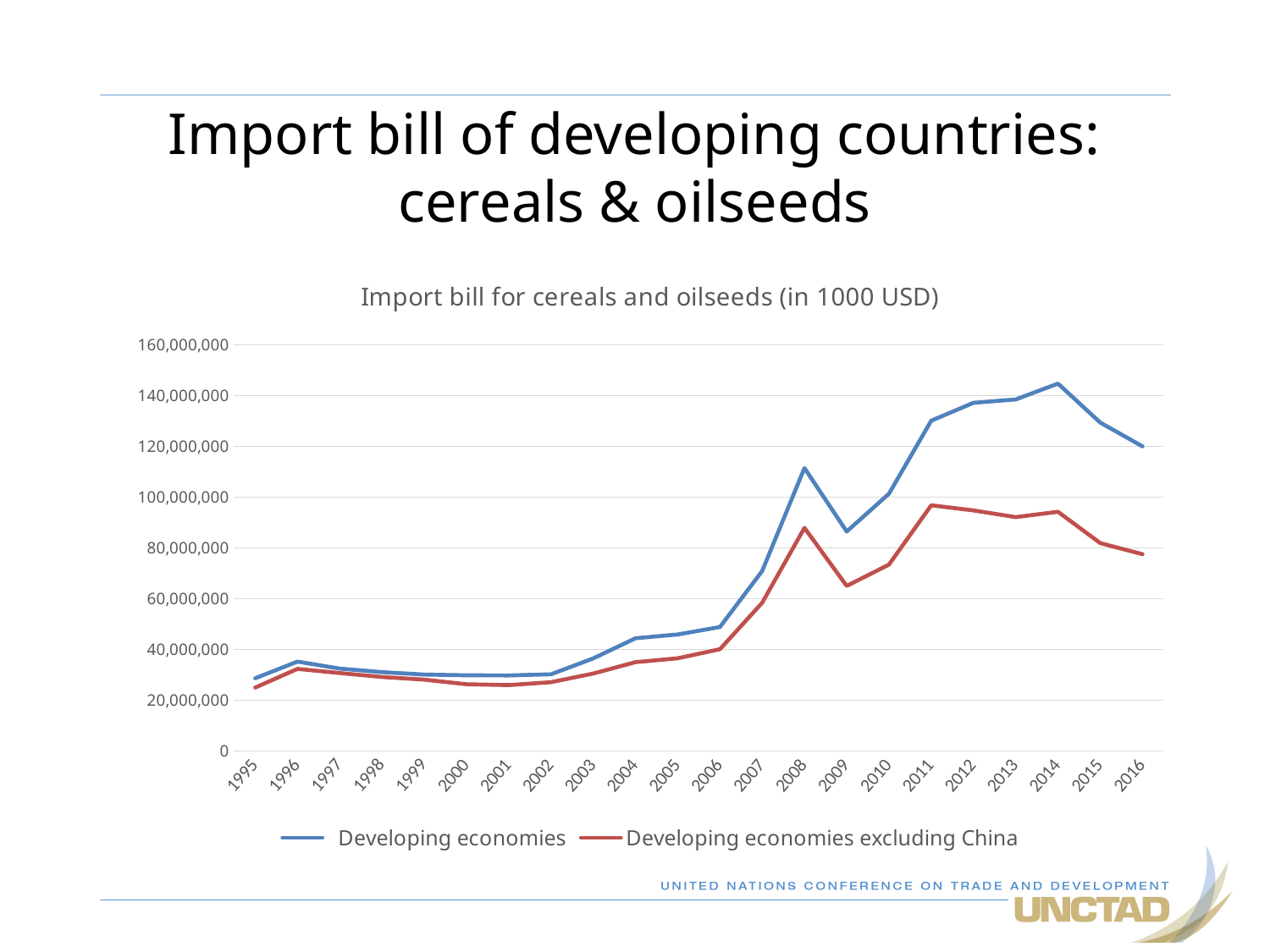
What is the title of the chart? Import bill for cereals and oilseeds (in 1000 USD) Does the Developing economies series rise or fall from 2014 to 2016? fall Is the value for Developing economies excluding China in 2016 greater or less than 100,000,000? less Is the value for Developing economies in 2014 greater or less than 140,000,000? greater How many years are plotted along the x axis? 22 Does the Developing economies excluding China series rise or fall from 2009 to 2011? rise Is the value for Developing economies excluding China in 2009 greater or less than 80,000,000? less What kind of chart is shown on the slide? line chart Which is larger for Developing economies: the value in 2008 or the value in 2009? 2008 How many series does the legend list? 2 In which year does the Developing economies series reach its highest value? 2014